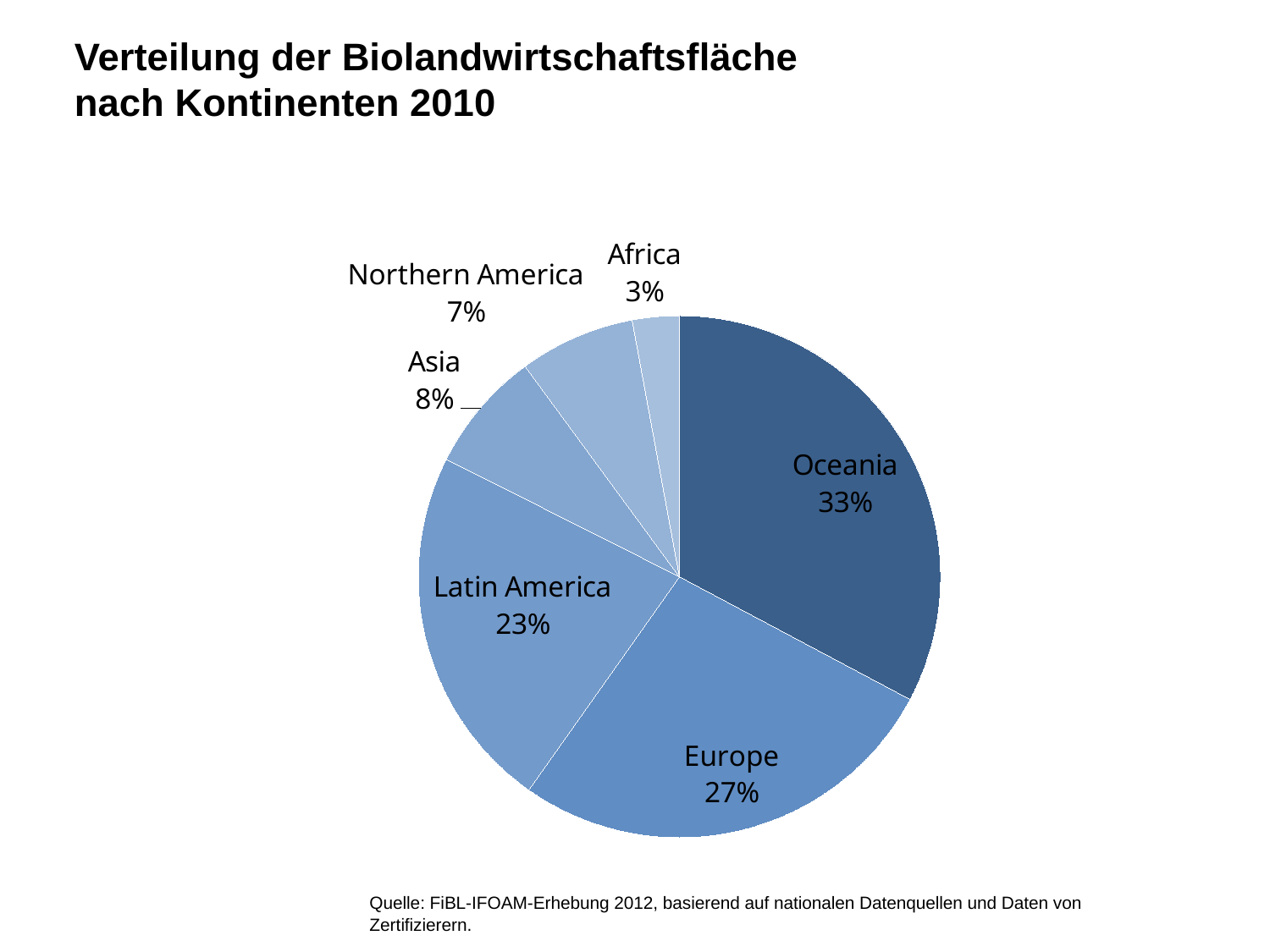
What is the difference in percentage points between Oceania and Europe? 6 How many continents are shown in the pie chart? 6 What share does Africa have? 3% What is the value for Latin America? 23% Which has a larger share, Latin America or Northern America? Latin America What percentage is shown for Asia? 8% What type of chart is shown on the slide? Pie chart Which continent has the largest share of the pie? Oceania Which continent has the smallest share of the pie? Africa What share of the organic agricultural area does Oceania hold? 33% What percentage is shown for Europe? 27% What is the title of the chart? Verteilung der Biolandwirtschaftsfläche nach Kontinenten 2010